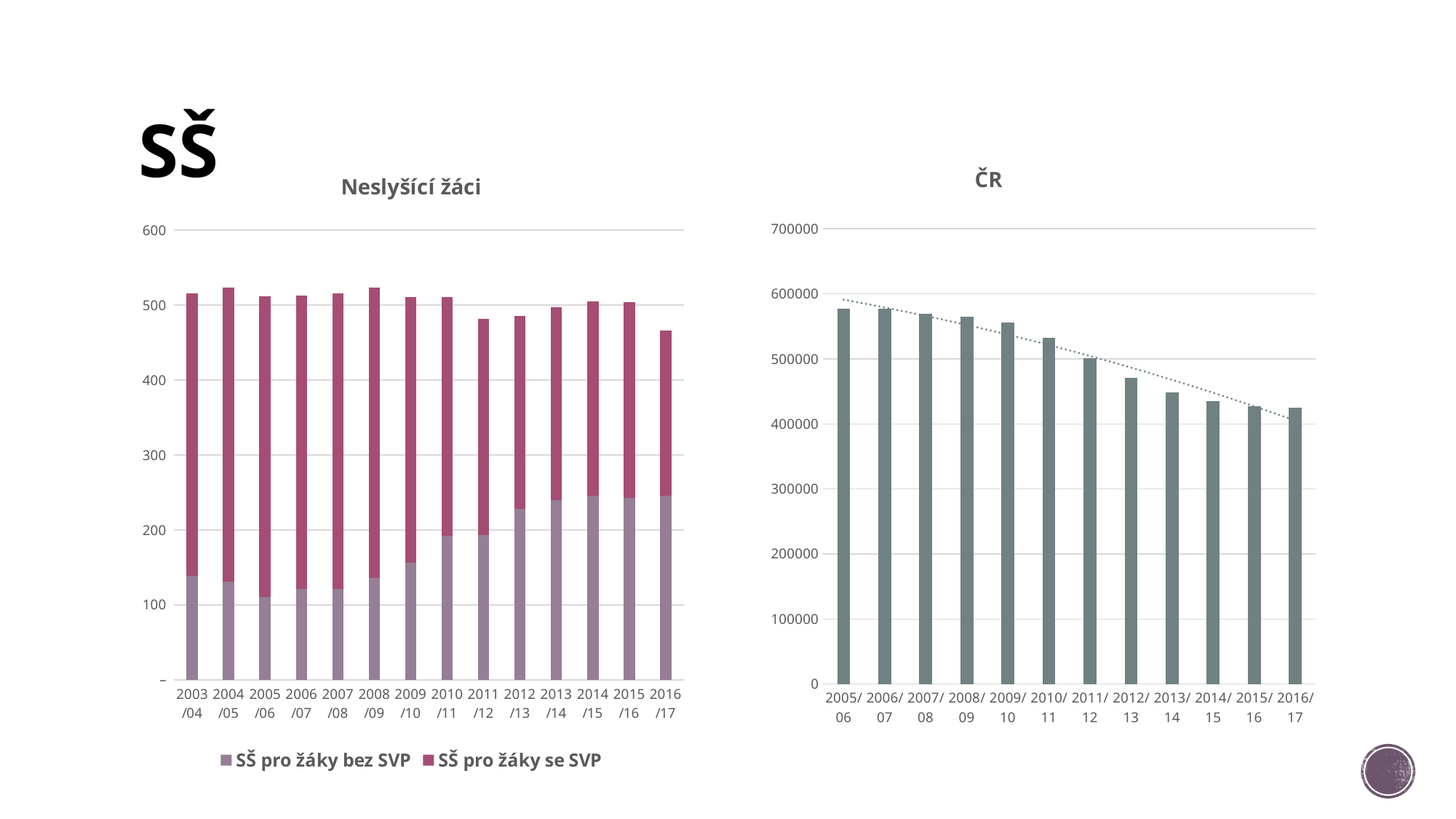
How many school years are shown on the x axis of the "ČR" chart? 12 How many series does the legend of the "Neslyšící žáci" chart list? 2 In the "Neslyšící žáci" chart, is the total stacked bar for 2003/04 greater or less than 500? greater What kind of chart is the "ČR" chart? bar chart In the "Neslyšící žáci" chart, which legend entry is shown in the darker magenta colour? SŠ pro žáky se SVP In the "ČR" chart, do the values rise or fall from 2005/06 to 2016/17? fall What kind of chart is the "Neslyšící žáci" chart? stacked bar chart How many school years are shown on the x axis of the "Neslyšící žáci" chart? 14 In the "Neslyšící žáci" chart, which school year has the lowest total stacked bar? 2016/17 In the "ČR" chart, is the value for 2016/17 greater or less than 500000? less In the "Neslyšící žáci" chart, is the total stacked bar for 2016/17 greater or less than 500? less